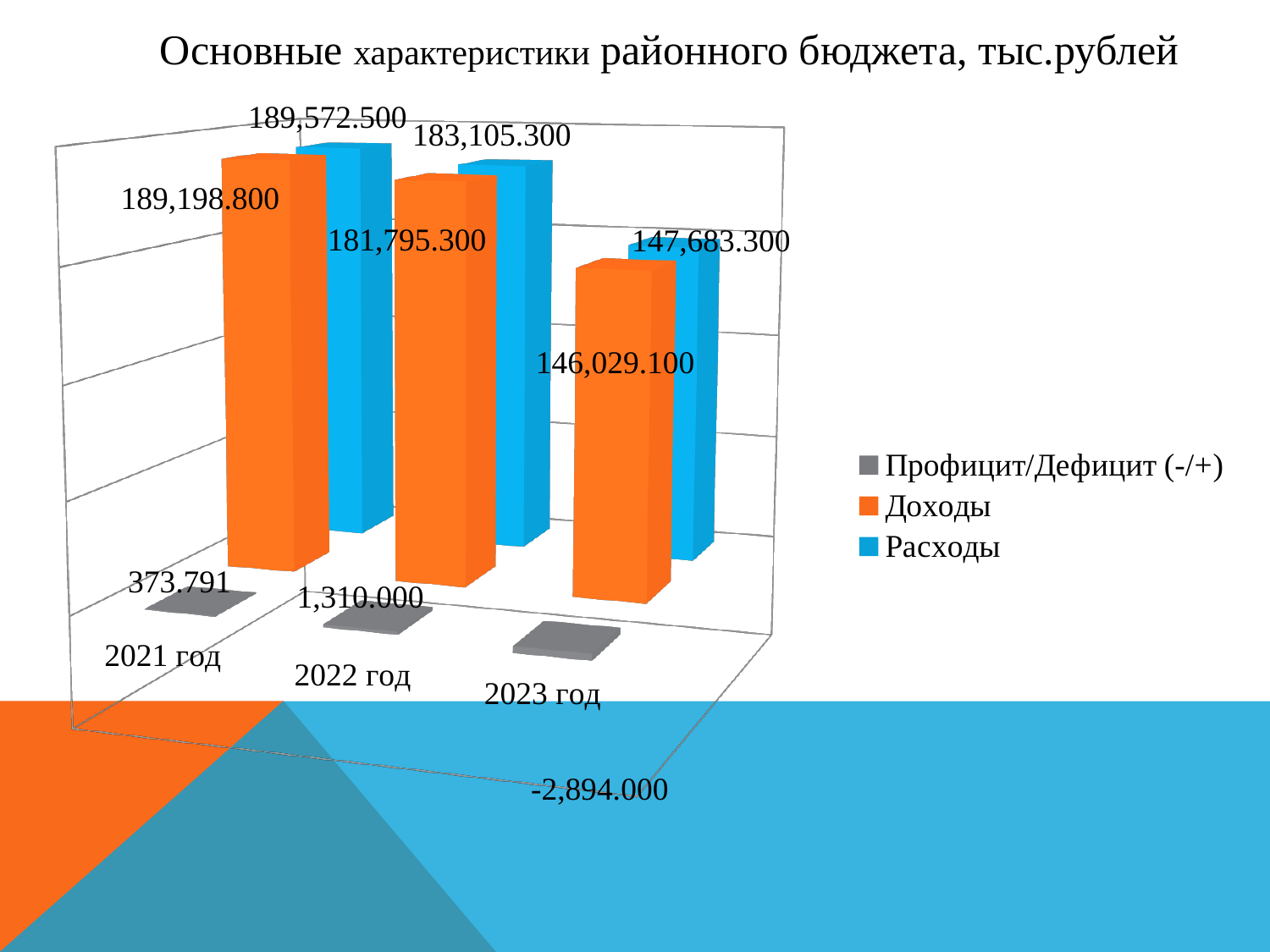
Do the Доходы values rise or fall from 2021 год to 2023 год? fall How many years (categories) are shown on the x axis? 3 What is the value of Расходы for 2023 год? 147,683.300 Which year has the lowest value of Расходы? 2023 год What is the value of Доходы for 2021 год? 189,198.800 What is the value of Расходы for 2022 год? 183,105.300 What type of chart is shown on the slide? bar chart What is the value of Профицит/Дефицит (-/+) for 2023 год? -2,894.000 What is the title of the chart? Основные характеристики районного бюджета, тыс.рублей How many series does the legend list? 3 Which year has the highest value of Доходы? 2021 год What is the difference between Доходы in 2021 год and Доходы in 2022 год? 7,403.500